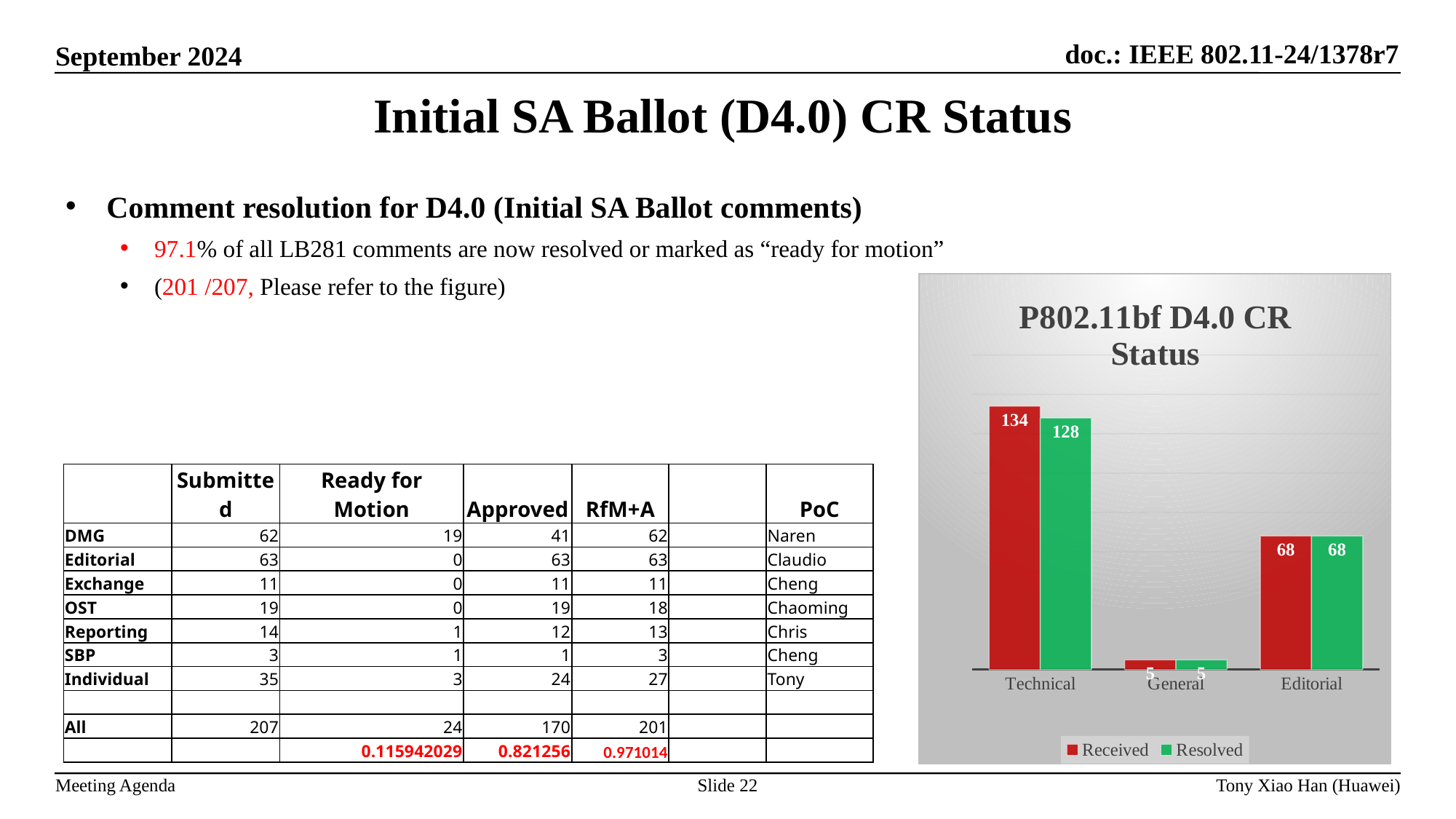
What is the Resolved value for General in the P802.11bf D4.0 CR Status chart? 5 What is the Resolved value for Technical in the P802.11bf D4.0 CR Status chart? 128 What kind of chart is the P802.11bf D4.0 CR Status chart? bar chart What is the Received value for Technical in the P802.11bf D4.0 CR Status chart? 134 How many categories are shown on the x axis of the P802.11bf D4.0 CR Status chart? 3 Which category has the highest Received value in the P802.11bf D4.0 CR Status chart? Technical Which category has the lowest Resolved value in the P802.11bf D4.0 CR Status chart? General What are the two legend entries in the P802.11bf D4.0 CR Status chart? Received, Resolved In the P802.11bf D4.0 CR Status chart, is the Received value for Technical larger than the Received value for Editorial? Yes How many series does the legend of the P802.11bf D4.0 CR Status chart list? 2 What is the Received value for Editorial in the P802.11bf D4.0 CR Status chart? 68 What is the difference between Received and Resolved for Technical in the P802.11bf D4.0 CR Status chart? 6